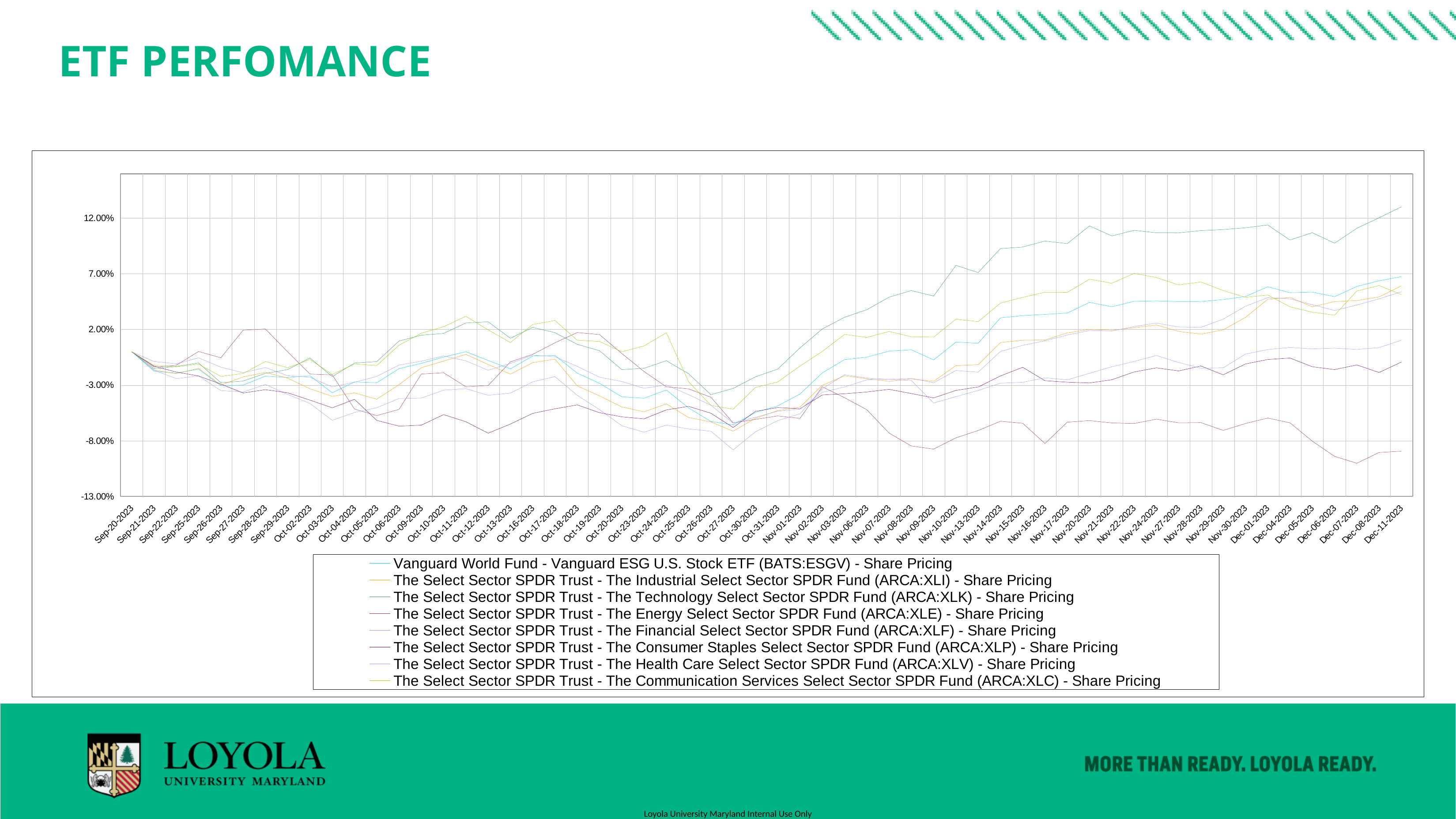
How many series does the legend list? 8 What is the first date shown on the x axis? Sep-20-2023 Which series is highest on Dec-11-2023? The Technology Select Sector SPDR Fund (ARCA:XLK) What kind of chart is shown on the slide? line chart Is the value for the Vanguard ESG U.S. Stock ETF (BATS:ESGV) on Oct-27-2023 greater or less than -3.00%? less Does the Energy Select Sector SPDR Fund (ARCA:XLE) line rise or fall overall from Sep-20-2023 to Dec-11-2023? fall On Dec-11-2023, which is larger: the Technology Select Sector SPDR Fund (ARCA:XLK) or the Energy Select Sector SPDR Fund (ARCA:XLE)? The Technology Select Sector SPDR Fund (ARCA:XLK) Which series is lowest on Dec-11-2023? The Energy Select Sector SPDR Fund (ARCA:XLE) Is the value for the Technology Select Sector SPDR Fund (ARCA:XLK) on Dec-11-2023 greater or less than 12.00%? greater Does the Technology Select Sector SPDR Fund (ARCA:XLK) line rise or fall overall from Sep-20-2023 to Dec-11-2023? rise What is the title of the slide containing the chart? ETF PERFOMANCE Is the value for the Energy Select Sector SPDR Fund (ARCA:XLE) on Dec-07-2023 greater or less than -8.00%? less